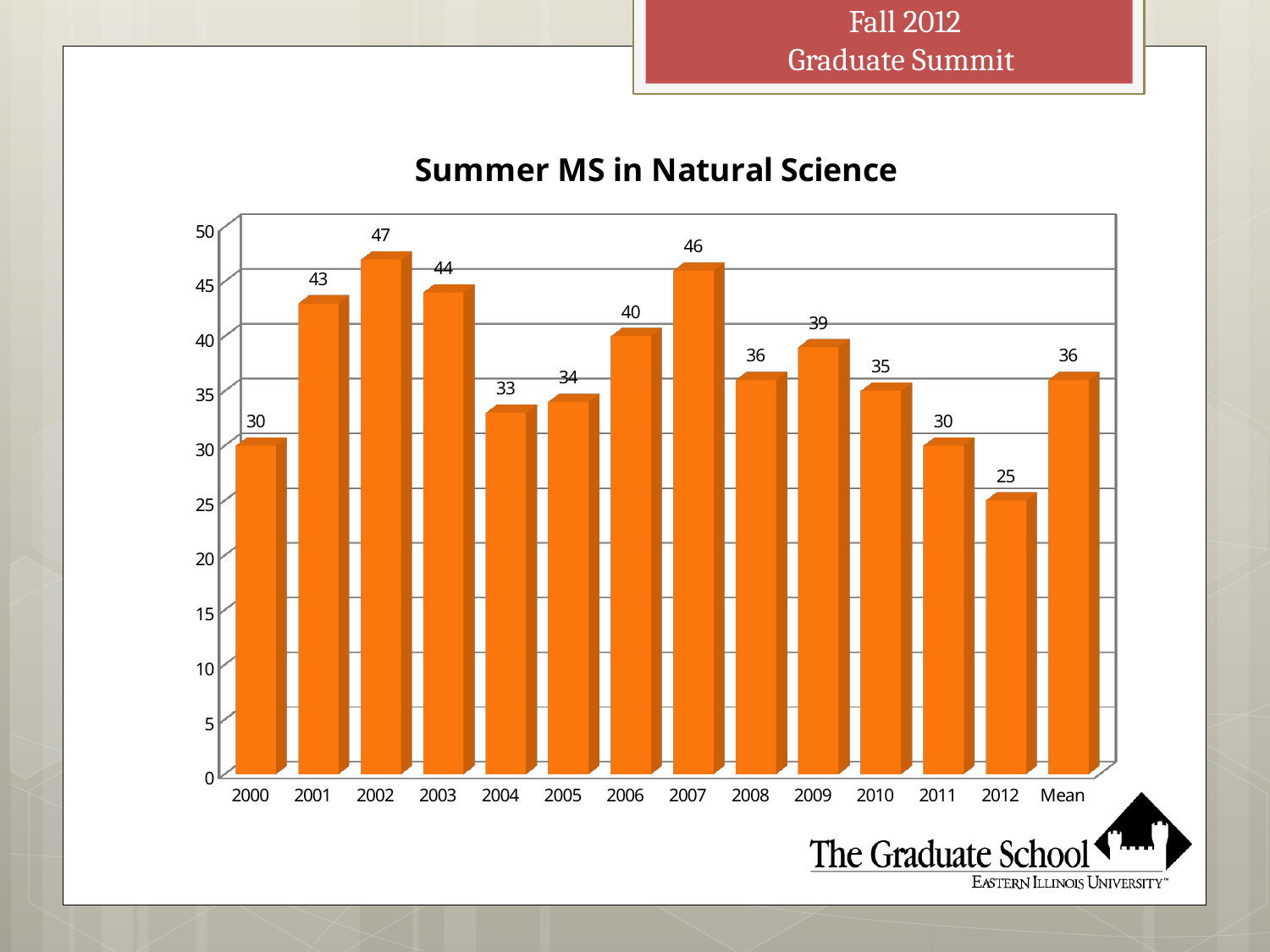
Is the value for 2009 greater or less than 35? greater Do the values rise or fall from 2009 to 2012? Fall What kind of chart is shown? Bar chart What is the value for 2002? 47 Which year has the highest value? 2002 Which category has the lowest value? 2012 What is the difference between the values for 2007 and 2008? 10 How many bars are plotted in the chart? 14 What is the value for 2012? 25 What is the value shown for Mean? 36 Which is larger, the value for 2003 or the value for 2006? 2003 What is the title of the chart? Summer MS in Natural Science